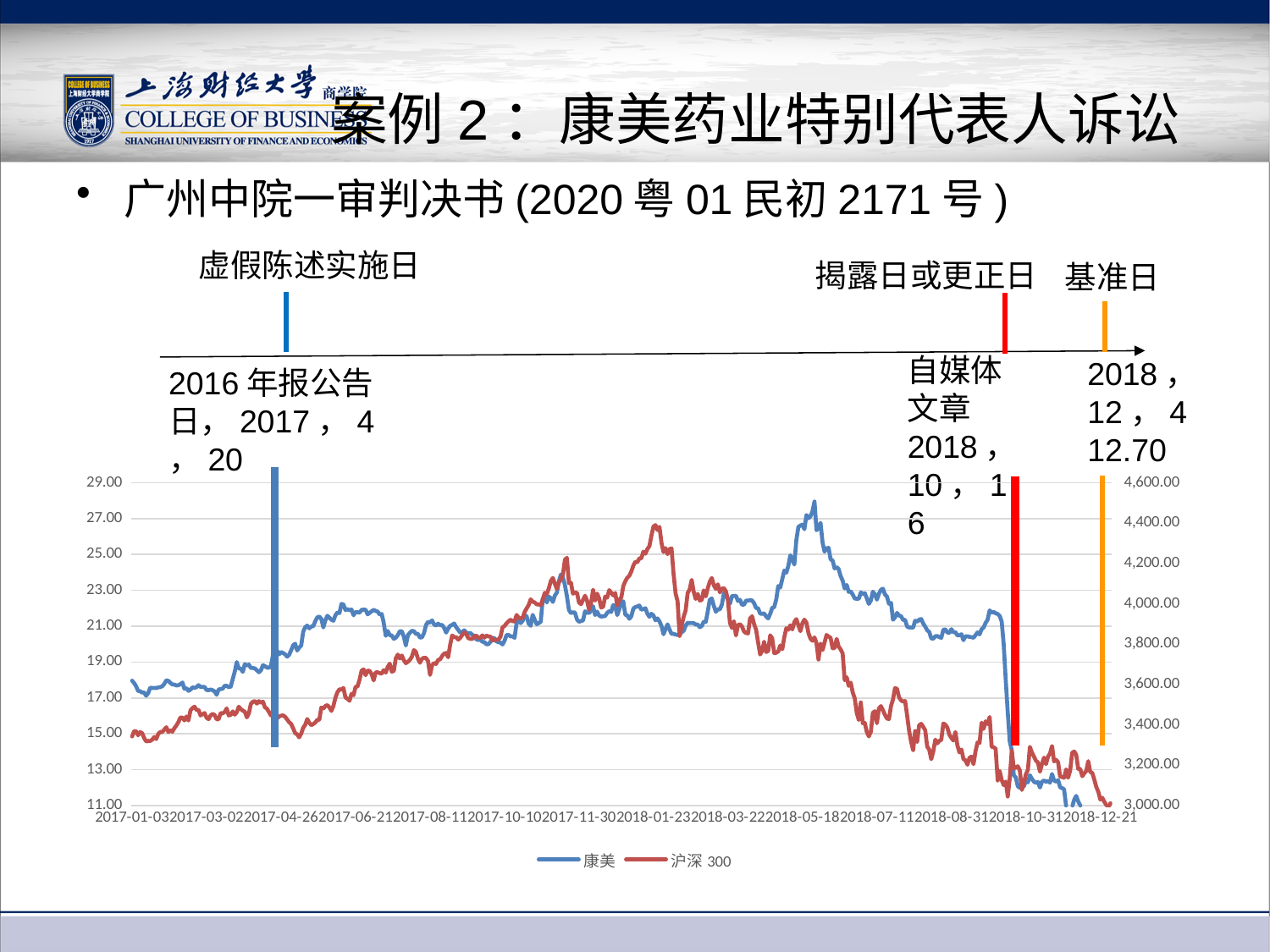
What are the two series named in the chart's legend? 康美 and 沪深 300 Is the value of the 康美 line at its highest peak (around May 2018) greater or less than 27.00? greater Does the 康美 line rise or fall between 2018-10-31 and 2018-12-21? fall Is the value of the 康美 line at the start of the chart (2017-01-03) greater or less than 15.00? greater How many series does the chart's legend list? 2 How many date labels are shown on the chart's x axis? 14 What kind of chart is shown on the slide? line chart What colour is the 康美 line in the chart? blue What value is annotated for 康美 at the 基准日 (2018-12-4)? 12.70 Does the 沪深 300 line rise or fall overall from 2018-01-23 to 2018-12-21? fall Is the value of the 沪深 300 line at the end of the chart (2018-12-21) greater or less than 3,200.00? less